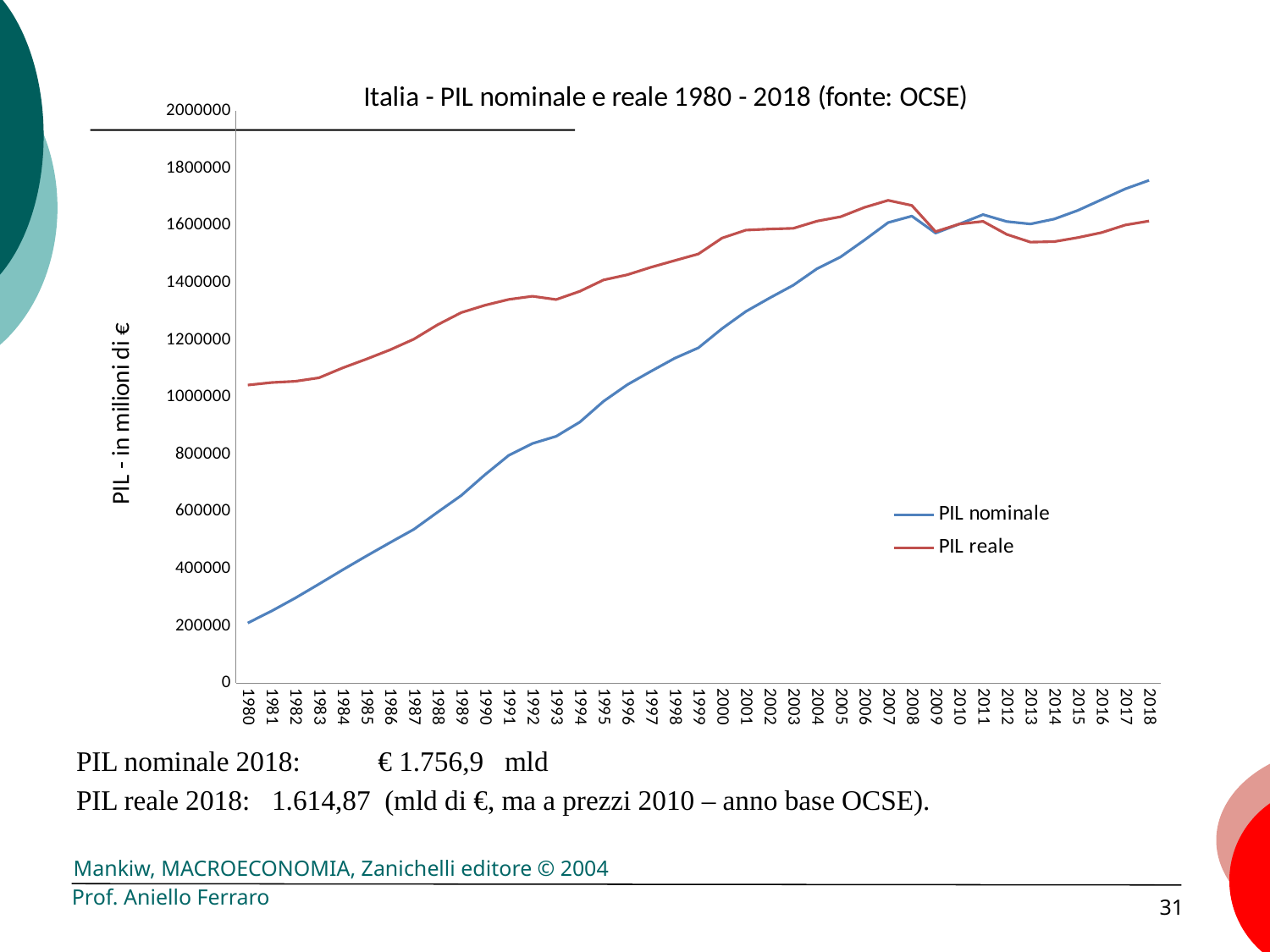
How many series does the chart's legend list? 2 In 2018, which series has the higher value, PIL nominale or PIL reale? PIL nominale Is the value of PIL nominale in 2018 greater or less than 1600000? greater Does the PIL nominale line rise or fall from 1980 to 2007? rise What are the two series named in the legend? PIL nominale and PIL reale How many years are shown on the x axis of the chart? 39 Is the value of PIL reale in 1980 greater or less than 800000? greater In 1990, which series has the higher value, PIL nominale or PIL reale? PIL reale What kind of chart is shown on the slide? line chart Is the value of PIL reale in 2013 greater or less than 1600000? less What is the title of the chart? Italia - PIL nominale e reale 1980 - 2018 (fonte: OCSE)